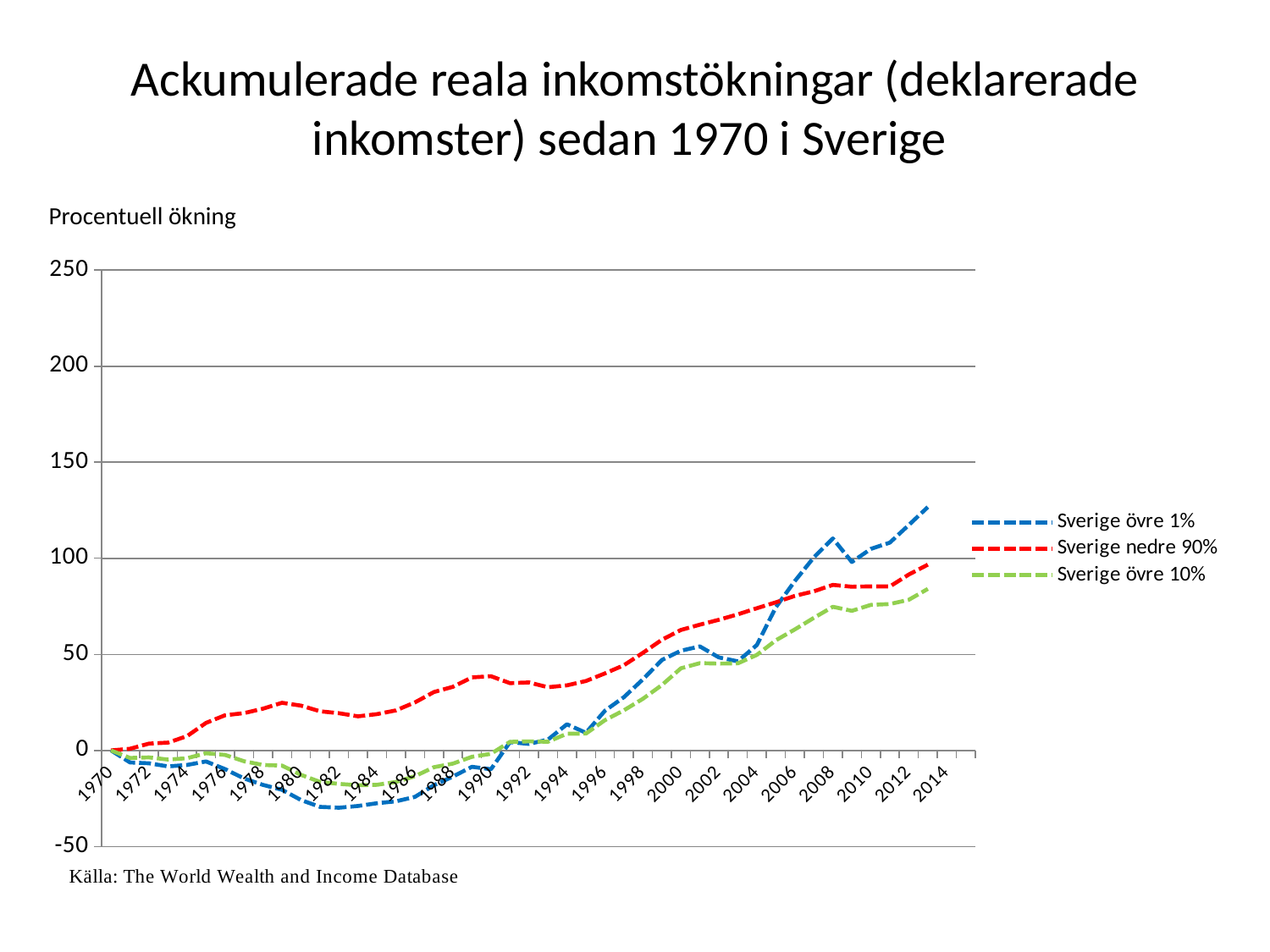
In 1990, which series has the higher value, Sverige nedre 90% or Sverige övre 1%? Sverige nedre 90% Is the value for Sverige övre 1% in 1982 greater or less than 0? less What are the three series named in the legend? Sverige övre 1%, Sverige nedre 90%, Sverige övre 10% Is the value for Sverige nedre 90% in 1980 greater or less than 50? less Which series has the lowest value around 1982? Sverige övre 1% How many series does the legend list? 3 What kind of chart is shown on the slide? Line chart Is the value for Sverige övre 10% in 2008 greater or less than 50? greater Overall, does the Sverige nedre 90% series rise or fall from 1970 to the end of the period? rise At the final point of the series, which is higher, Sverige övre 1% or Sverige nedre 90%? Sverige övre 1% What label is shown above the vertical axis of the chart? Procentuell ökning